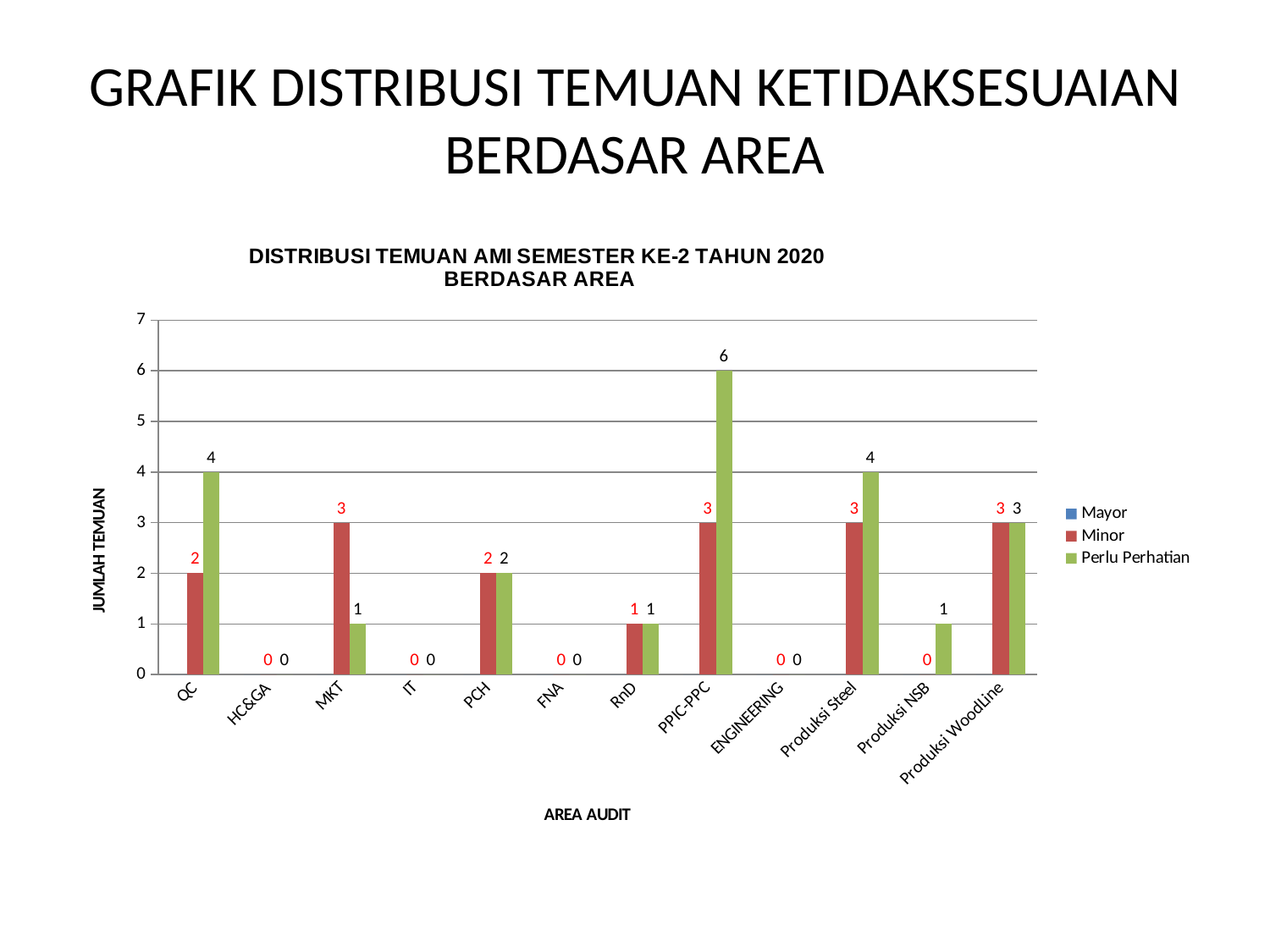
What is the Minor value for MKT? 3 What is the difference between the Perlu Perhatian and Minor values for PPIC-PPC? 3 Which is larger, the Minor value for QC or the Minor value for MKT? MKT What kind of chart is shown on the slide? Bar chart What is the Minor value for Produksi WoodLine? 3 Which area has the highest Perlu Perhatian value? PPIC-PPC What is the Perlu Perhatian value for Produksi NSB? 1 What is the title of the vertical axis? JUMLAH TEMUAN What is the Perlu Perhatian value for PPIC-PPC? 6 How many audit areas are shown on the x axis? 12 What is the difference between the Perlu Perhatian and Minor values for Produksi Steel? 1 How many series does the legend list? 3